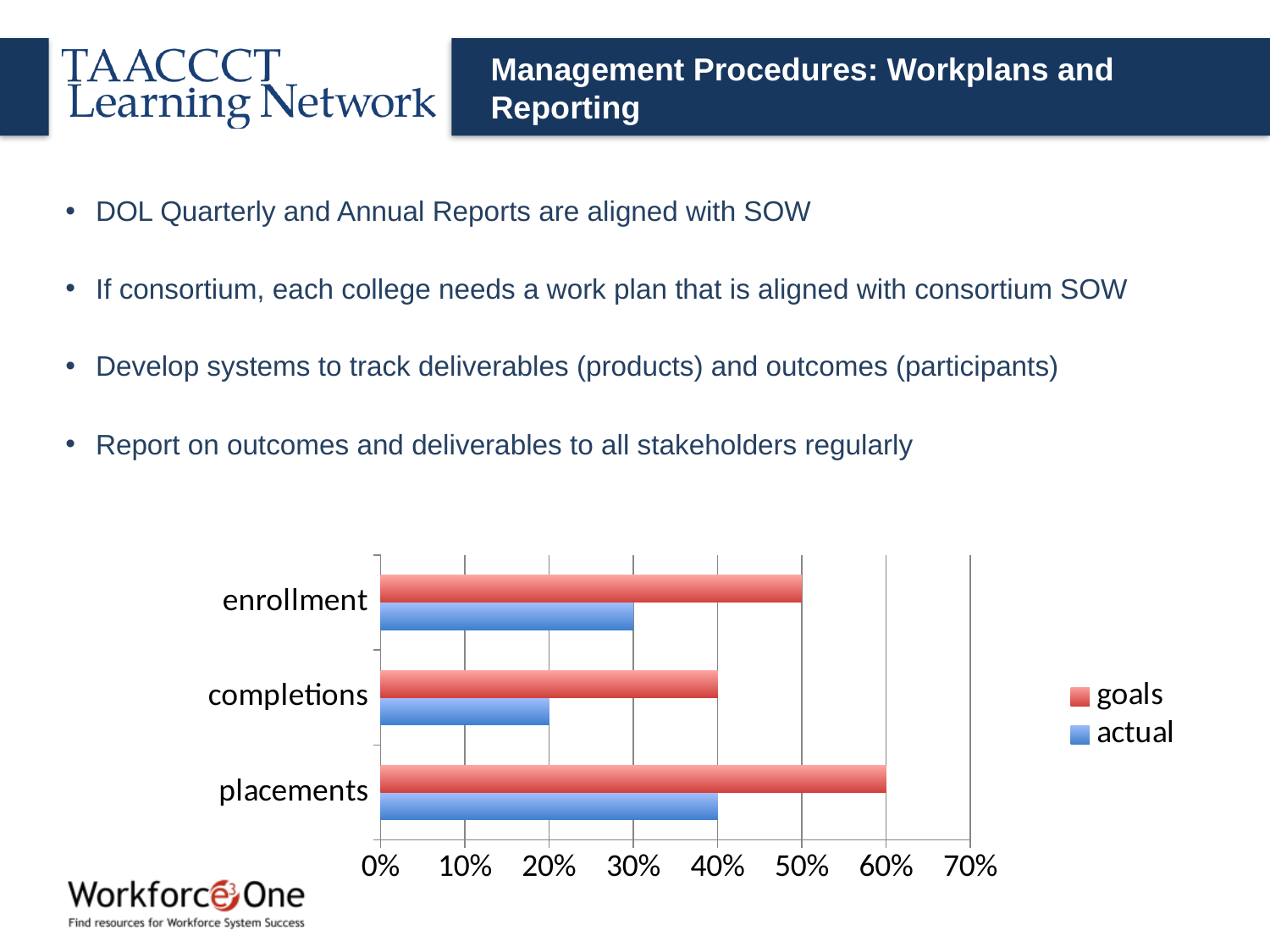
What kind of chart is shown on the slide? bar chart Which category has the highest goals value? placements How many categories does the chart show? 3 What is the difference between the goals and actual values for enrollment? 20% Which is larger: the goals value for completions or the actual value for placements? They are equal (40%) Is the goals value for enrollment greater or less than 40%? greater What is the actual value for completions? 20% Which series is shown in red? goals How many series does the legend list? 2 What is the goals value for placements? 60% Which category has the lowest actual value? completions What is the actual value for enrollment? 30%